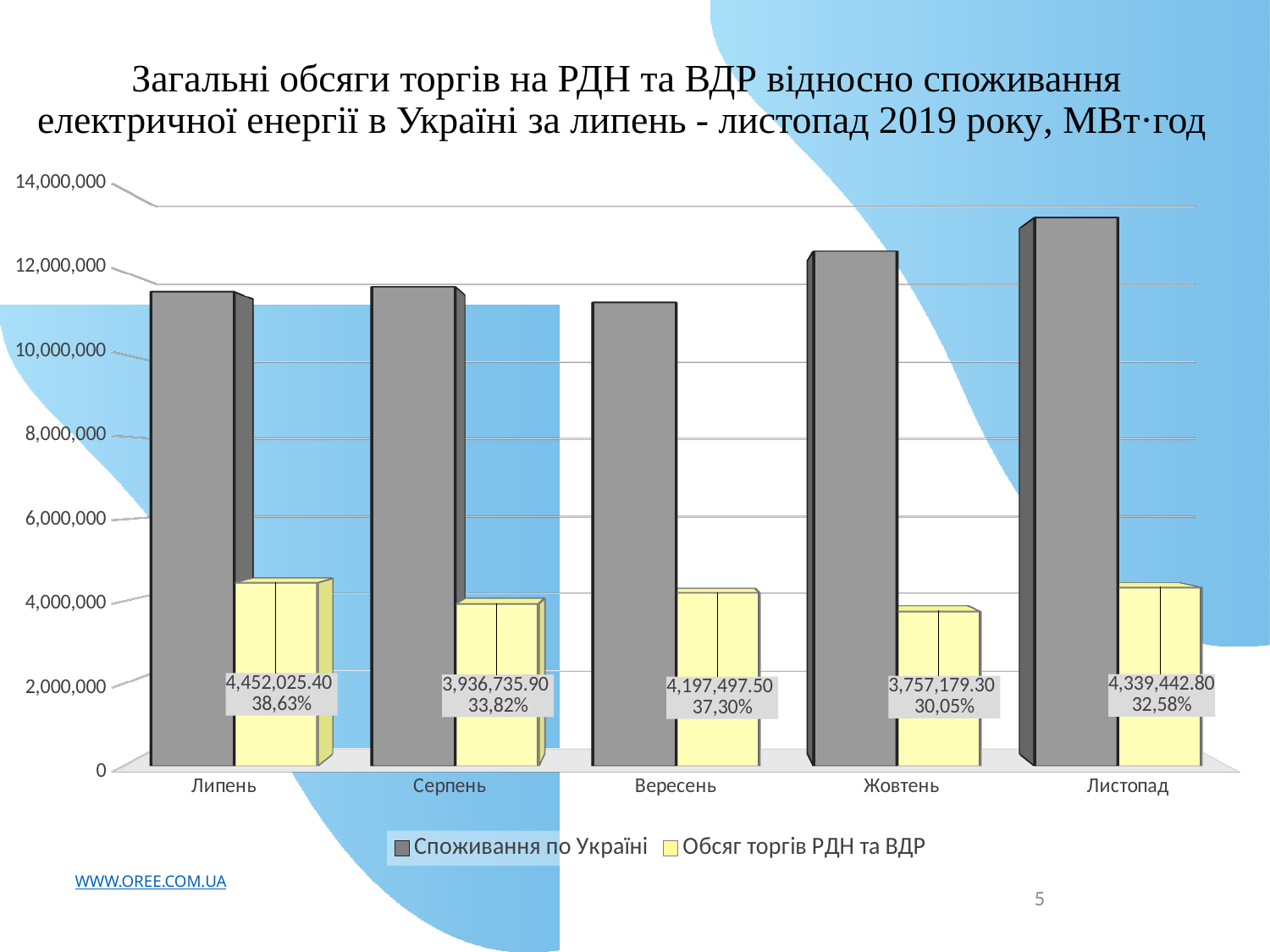
Is the value of Споживання по Україні for Листопад greater or less than 12,000,000? greater Which month has the highest value for Обсяг торгів РДН та ВДР? Липень How many series does the legend list? 2 Is the value of Споживання по Україні for Вересень greater or less than 12,000,000? less Which month has the highest value for Споживання по Україні? Листопад What is the difference between the Обсяг торгів РДН та ВДР values for Липень and Жовтень? 694,846.10 What percentage is shown on the Обсяг торгів РДН та ВДР bar for Вересень? 37,30% Which is larger, the Обсяг торгів РДН та ВДР value for Серпень or for Вересень? Вересень Which month has the lowest value for Обсяг торгів РДН та ВДР? Жовтень How many months are shown on the x axis? 5 What is the value of Обсяг торгів РДН та ВДР for Липень? 4,452,025.40 What is the value of Обсяг торгів РДН та ВДР for Жовтень? 3,757,179.30